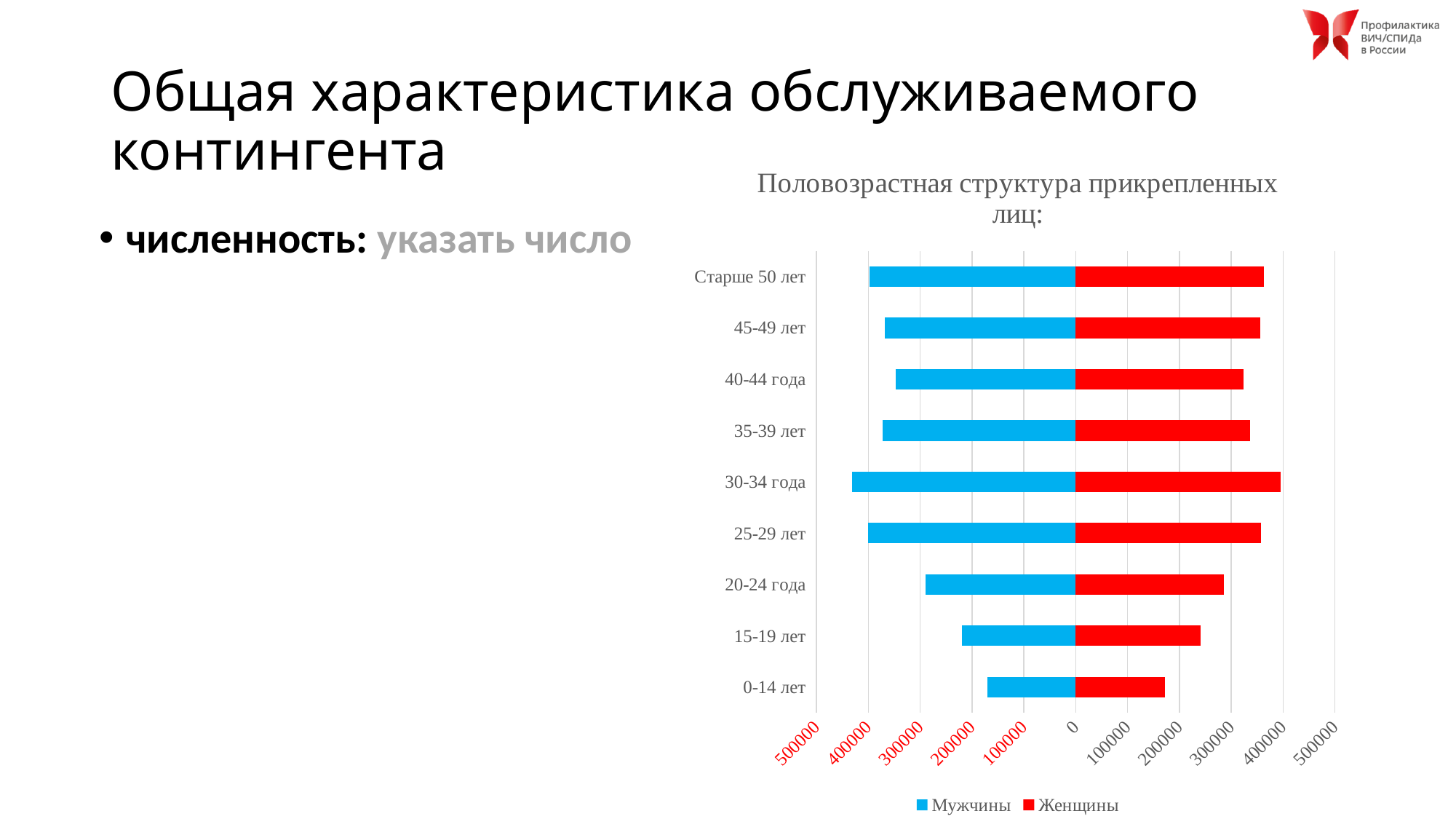
Which age category has the lowest value for Женщины? 0-14 лет Which is larger: the value for Мужчины in 30-34 года or in 20-24 года? 30-34 года Which age category has the highest value for Мужчины? 30-34 года Is the value for Женщины in the 0-14 лет category greater or less than 200000? less How many series does the chart legend list? 2 Which age category has the highest value for Женщины? 30-34 года What kind of chart is shown on the slide? bar chart How many age categories are shown on the chart? 9 Is the value for Мужчины in the 30-34 года category greater or less than 400000? greater What is the title of the chart? Половозрастная структура прикрепленных лиц: Which age category has the lowest value for Мужчины? 0-14 лет Which colour represents the series Мужчины? blue